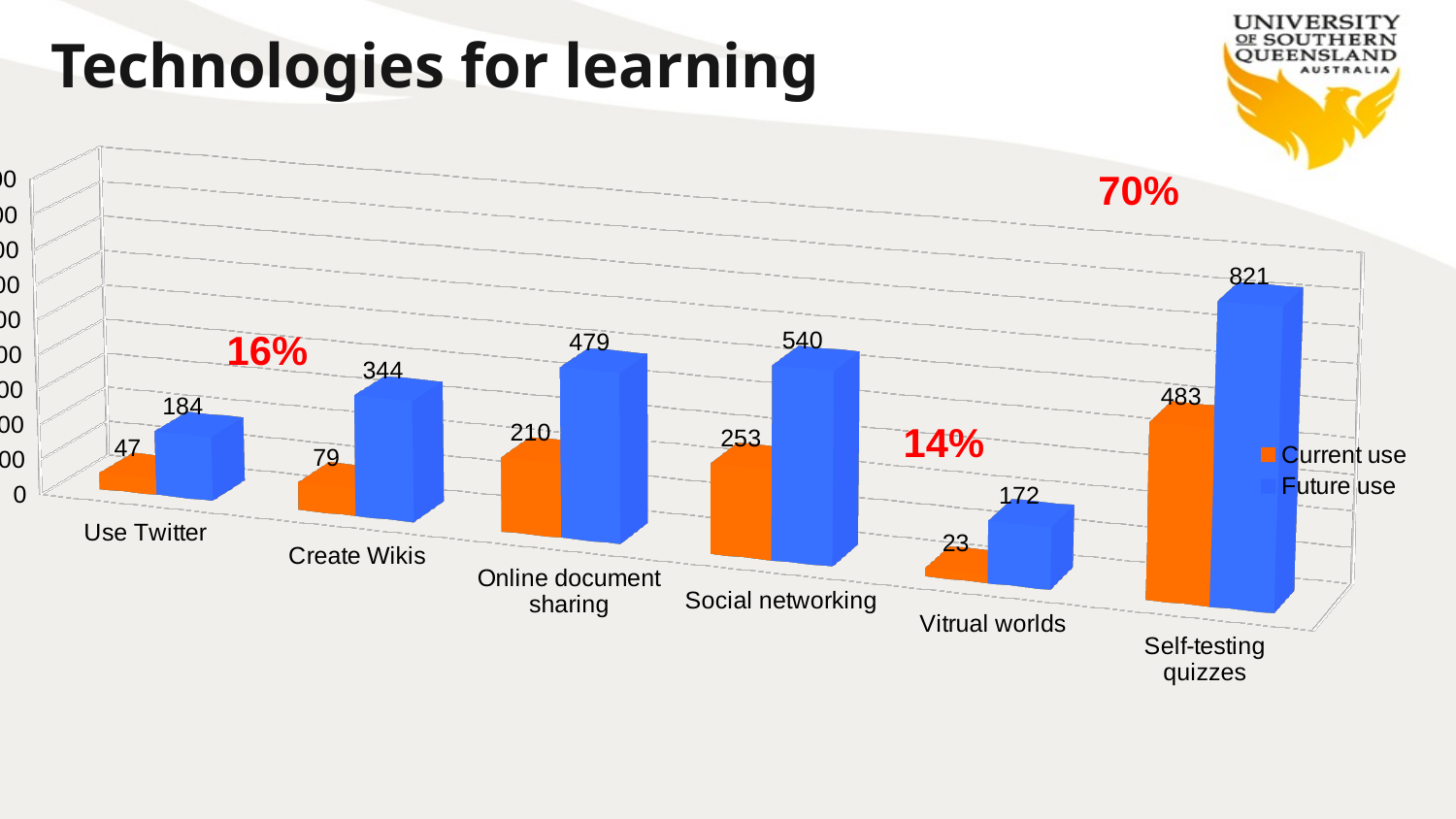
How many series does the legend list? 2 Which series is shown in orange? Current use Which category has the highest Future use value? Self-testing quizzes How many categories are shown on the x axis? 6 What is the Future use value for Social networking? 540 What is the difference between the Future use values for Create Wikis and Use Twitter? 160 What is the difference between Future use and Current use for Self-testing quizzes? 338 Which is larger, the Current use value for Social networking or the Current use value for Create Wikis? Social networking Which category has the lowest Current use value? Vitrual worlds What is the Current use value for Online document sharing? 210 What kind of chart is shown on the slide? Bar chart What is the Current use value for Use Twitter? 47